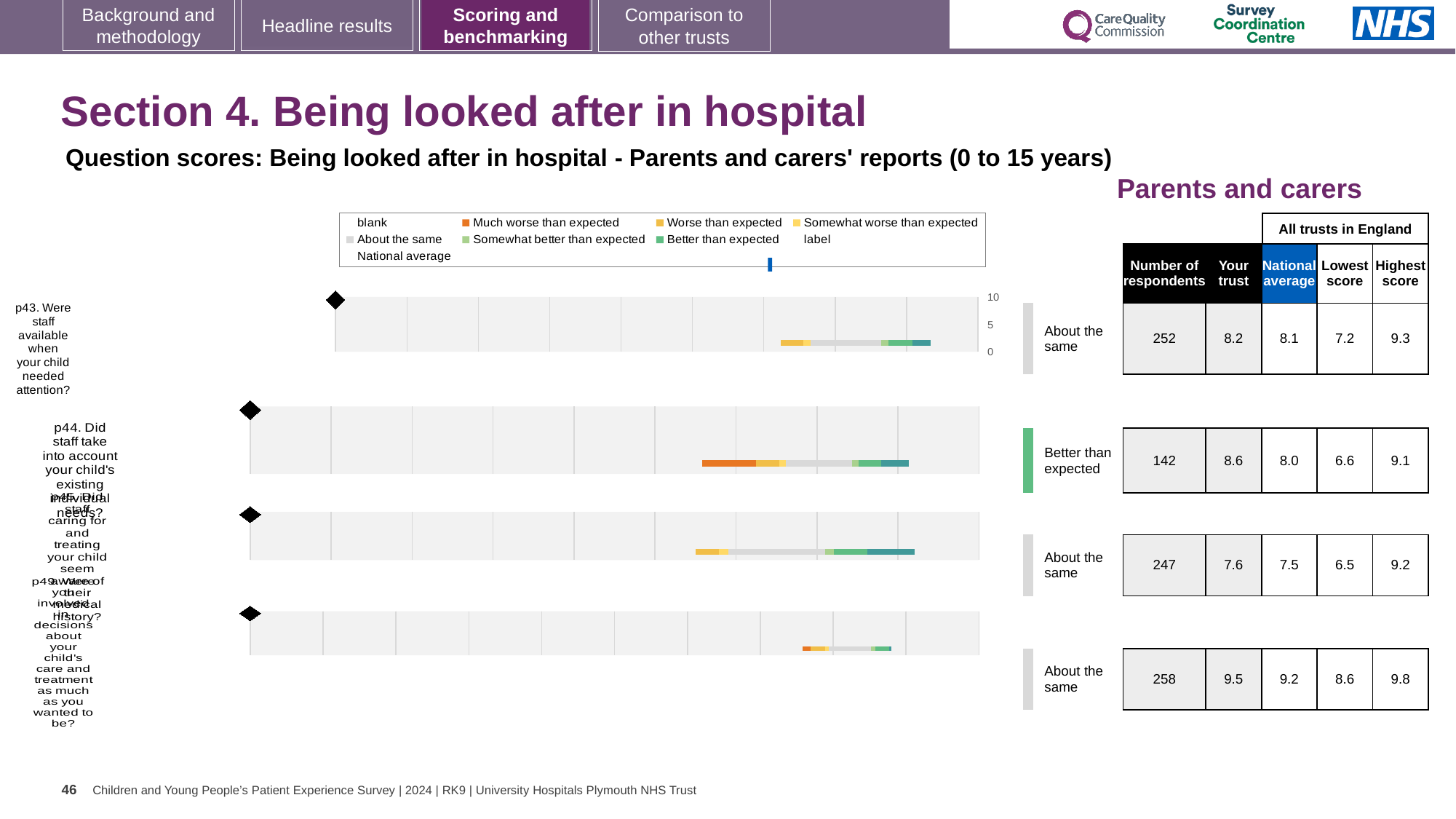
Which question has the lowest 'Your trust' score? p45 How many questions (categories) are plotted in the chart? 4 What is the national average score for p45? 7.5 What is the lowest score across all trusts in England for p43? 7.2 What is the 'Your trust' score for p43 (Were staff available when your child needed attention?)? 8.2 What kind of chart is used to show the question scores on this slide? bar chart For p44, which is larger: the 'Your trust' score or the national average? Your trust Which benchmark category is shown for p44? Better than expected What is the highest score across all trusts in England for p49? 9.8 Which question has the highest 'Your trust' score? p49 What is the number of respondents for p44 (Did staff take into account your child's existing individual needs?)? 142 What is the difference between the 'Your trust' score and the national average for p49? 0.3